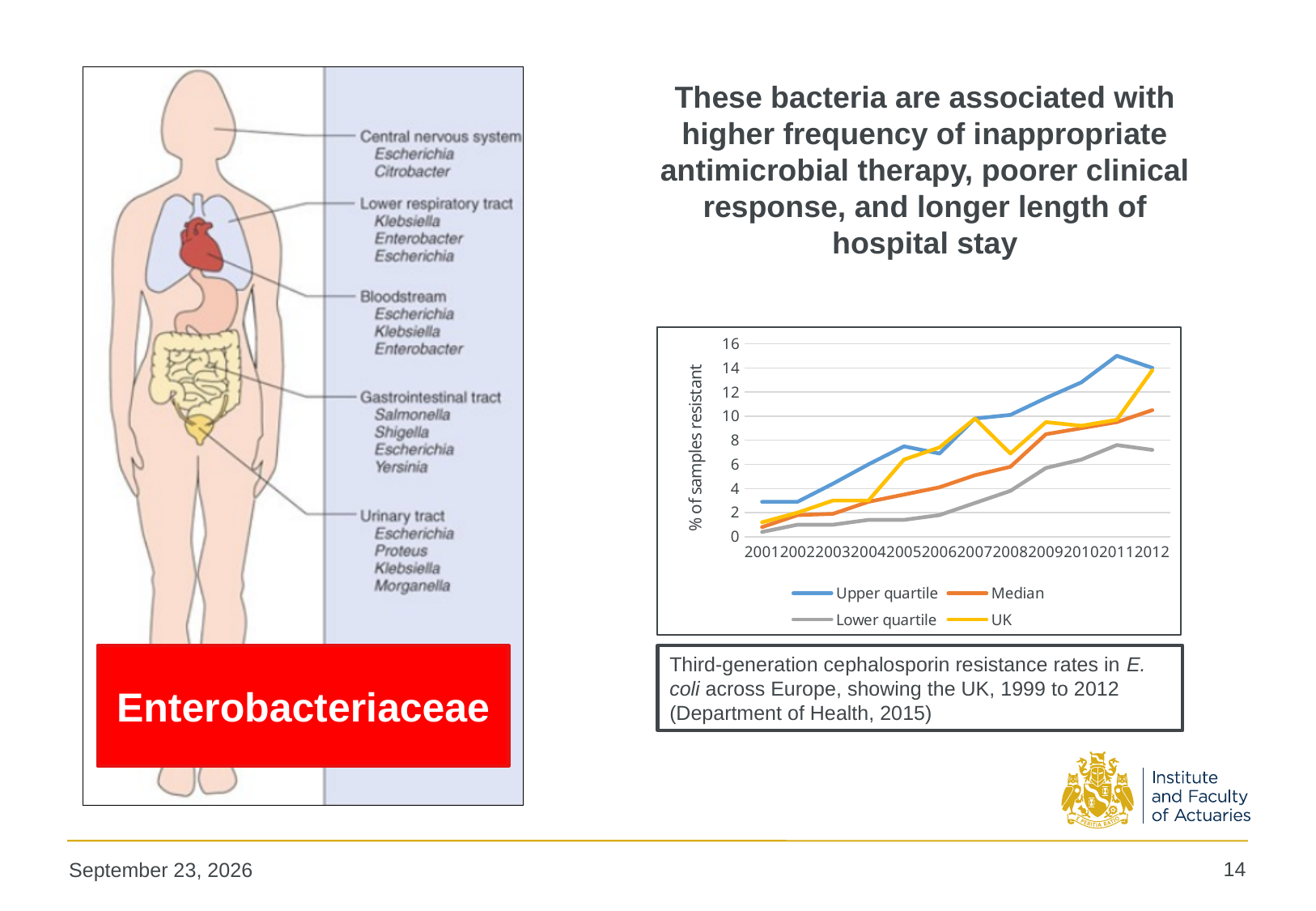
In 2012, which is larger: the UK value or the Median value? UK Is the value for Upper quartile in 2001 greater or less than 4? less In 2009, which is larger: the Median value or the Lower quartile value? Median Is the value for Upper quartile in 2011 greater or less than 14? greater Is the value for UK in 2012 greater or less than 12? greater How many series does the chart's legend list? 4 Which series is drawn in yellow in the chart? UK What kind of chart is shown on the slide? line chart Does the Upper quartile series generally rise or fall from 2001 to 2012? rise How many years are shown along the x axis of the chart? 12 What is the label on the vertical axis of the chart? % of samples resistant